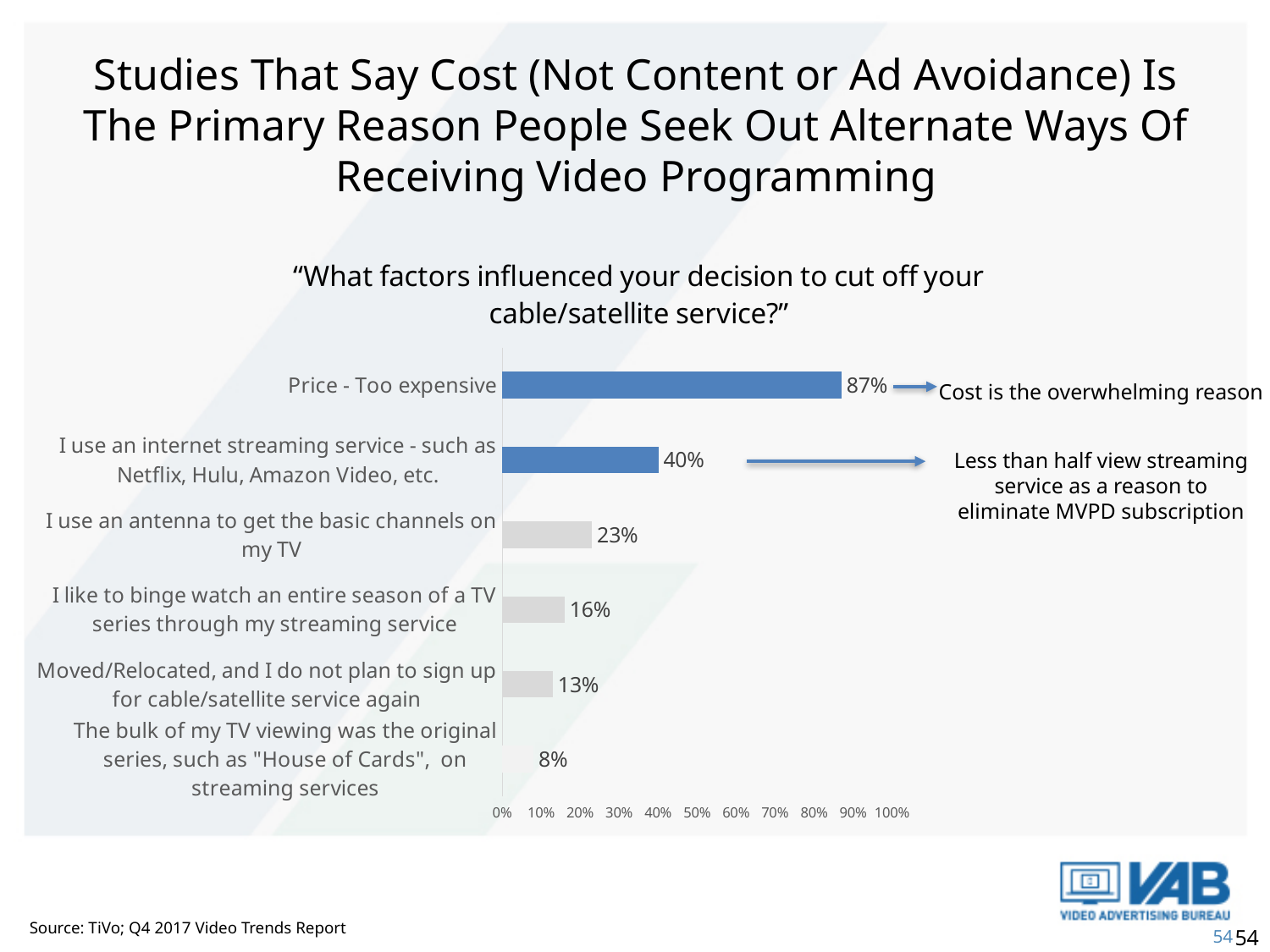
What percentage cited using an antenna to get the basic channels on their TV? 23% Which factor has the lowest percentage in the chart? The bulk of my TV viewing was the original series, such as "House of Cards", on streaming services What is the title (survey question) shown above the chart? "What factors influenced your decision to cut off your cable/satellite service?" What is the value for "I use an internet streaming service - such as Netflix, Hulu, Amazon Video, etc."? 40% Which factor has the highest percentage in the chart? Price - Too expensive What kind of chart is shown on the slide? Bar chart What is the difference in percentage points between the binge-watching factor (16%) and the moved/relocated factor (13%)? 3 What is the value for "Moved/Relocated, and I do not plan to sign up for cable/satellite service again"? 13% Which is larger: the value for binge watching an entire season through a streaming service, or the value for using an antenna to get basic channels? I use an antenna to get the basic channels on my TV What percentage of respondents cited "Price - Too expensive" as a factor in cutting off cable/satellite service? 87% What is the difference in percentage points between "Price - Too expensive" and "I use an internet streaming service"? 47 How many factors (categories) are shown in the chart? 6